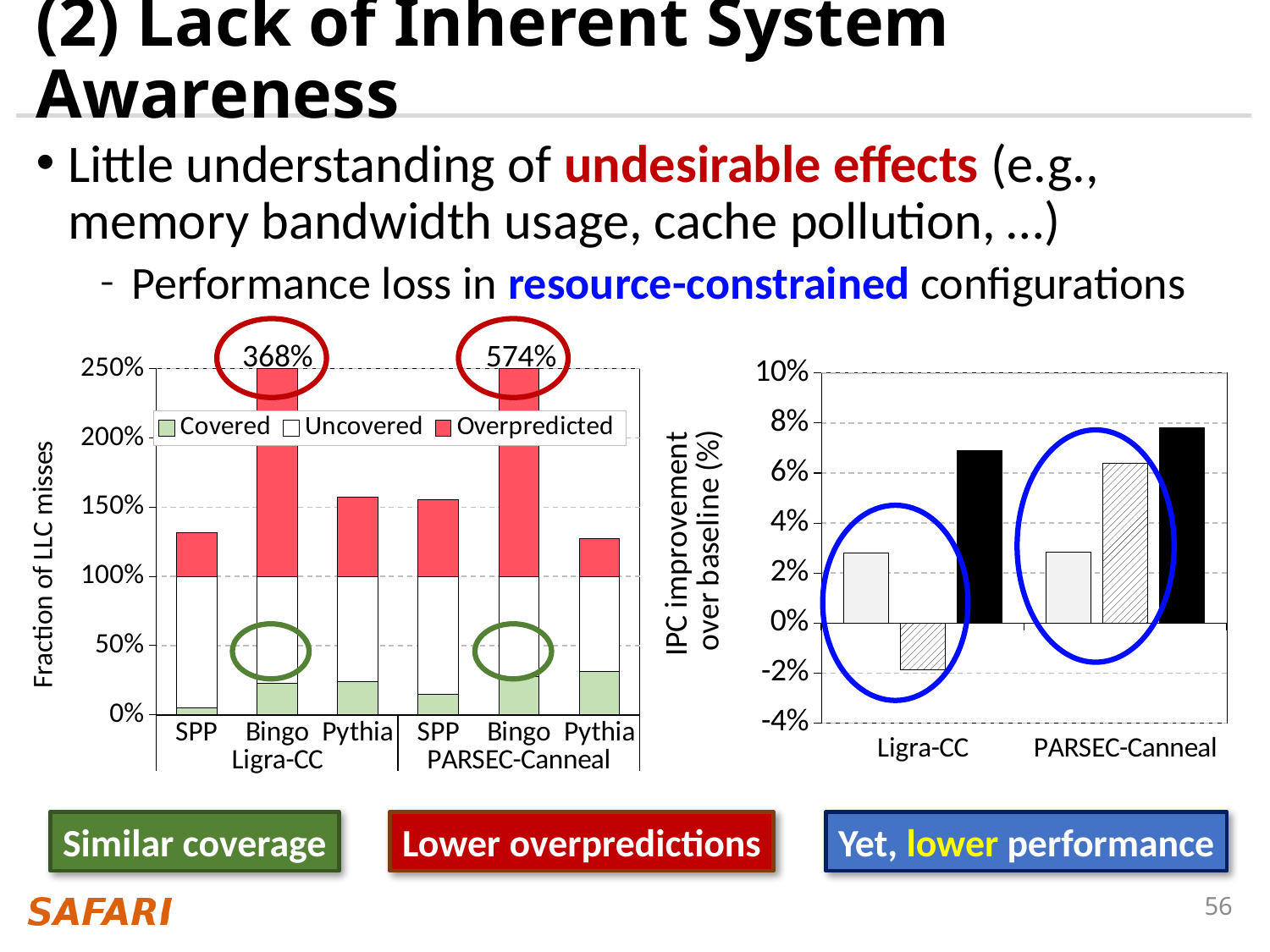
In the left chart (Fraction of LLC misses), what is the labelled value for Bingo under Ligra-CC? 368% In the left chart (Fraction of LLC misses), what is the difference between the labelled values for Bingo under PARSEC-Canneal and Bingo under Ligra-CC? 206% In the left chart (Fraction of LLC misses), which bar is the highest? Bingo under PARSEC-Canneal In the right chart (IPC improvement over baseline), is the second (hatched) bar for Ligra-CC greater or less than 0%? less How many series does the legend of the left chart (Fraction of LLC misses) list? 3 What are the legend entries of the left chart (Fraction of LLC misses)? Covered, Uncovered, Overpredicted What kind of chart is the left chart (Fraction of LLC misses)? Stacked bar chart What is the y-axis label of the right chart? IPC improvement over baseline (%) In the right chart (IPC improvement over baseline), is the black bar for PARSEC-Canneal greater or less than 6%? greater In the left chart (Fraction of LLC misses), what is the labelled value for Bingo under PARSEC-Canneal? 574% In the left chart (Fraction of LLC misses), is the total for SPP under Ligra-CC greater or less than 100%? greater How many bars are plotted in the left chart (Fraction of LLC misses)? 6